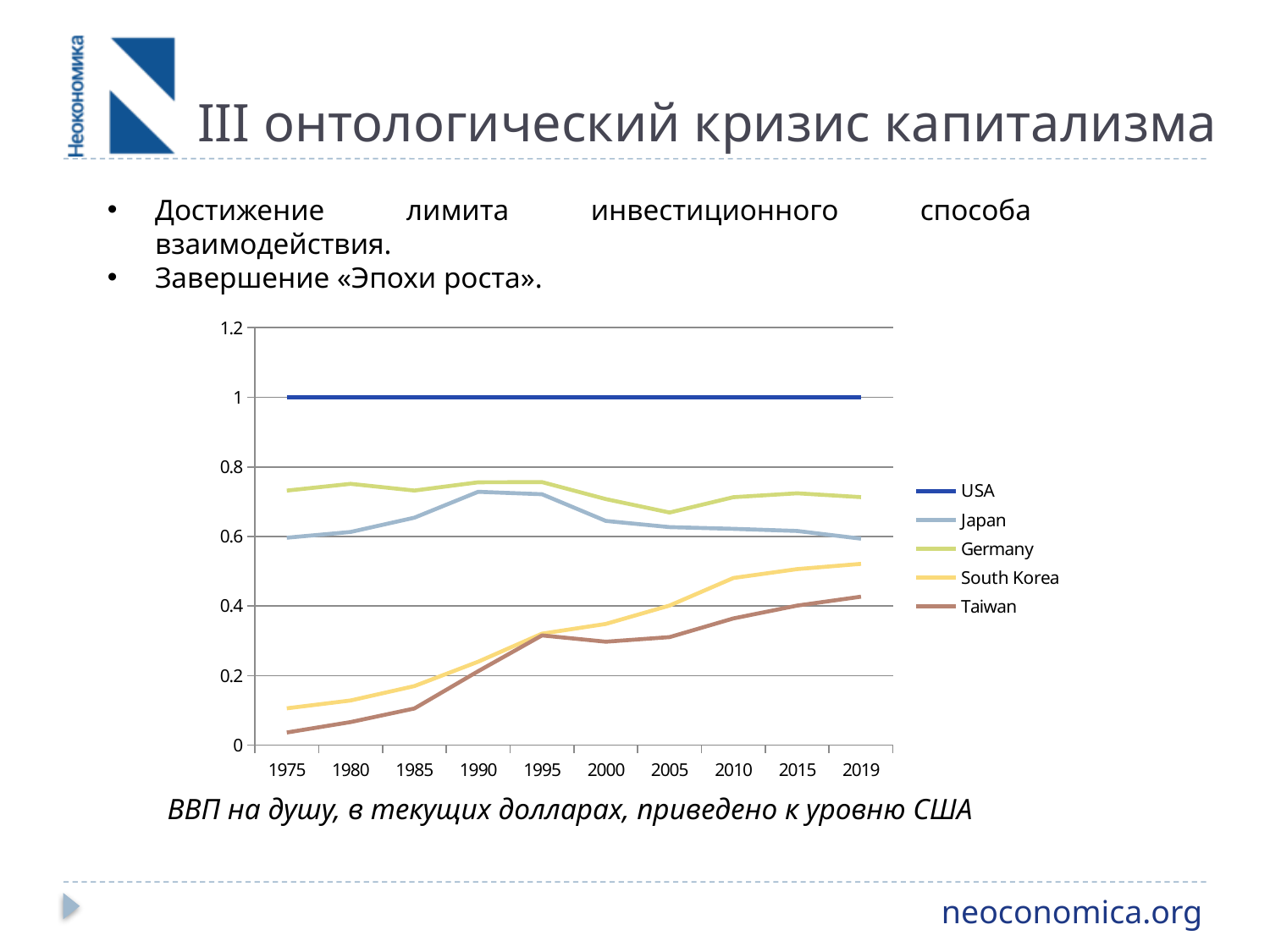
In 2019, which is larger: the value for Germany or the value for Japan? Germany Does the value for South Korea rise or fall from 1975 to 2019? rise Which series has the highest value in 2019? USA Which series has the lowest value in 1975? Taiwan Is the value for South Korea in 1975 greater or less than 0.2? less Which series is drawn in dark blue in the chart? USA Is the value for Japan in 1990 greater or less than 0.6? greater What is the value for USA in 2019? 1 What kind of chart is shown on the slide? line chart Is the value for Taiwan in 2019 greater or less than 0.4? greater How many years are marked along the x axis of the chart? 10 How many series does the chart legend list? 5